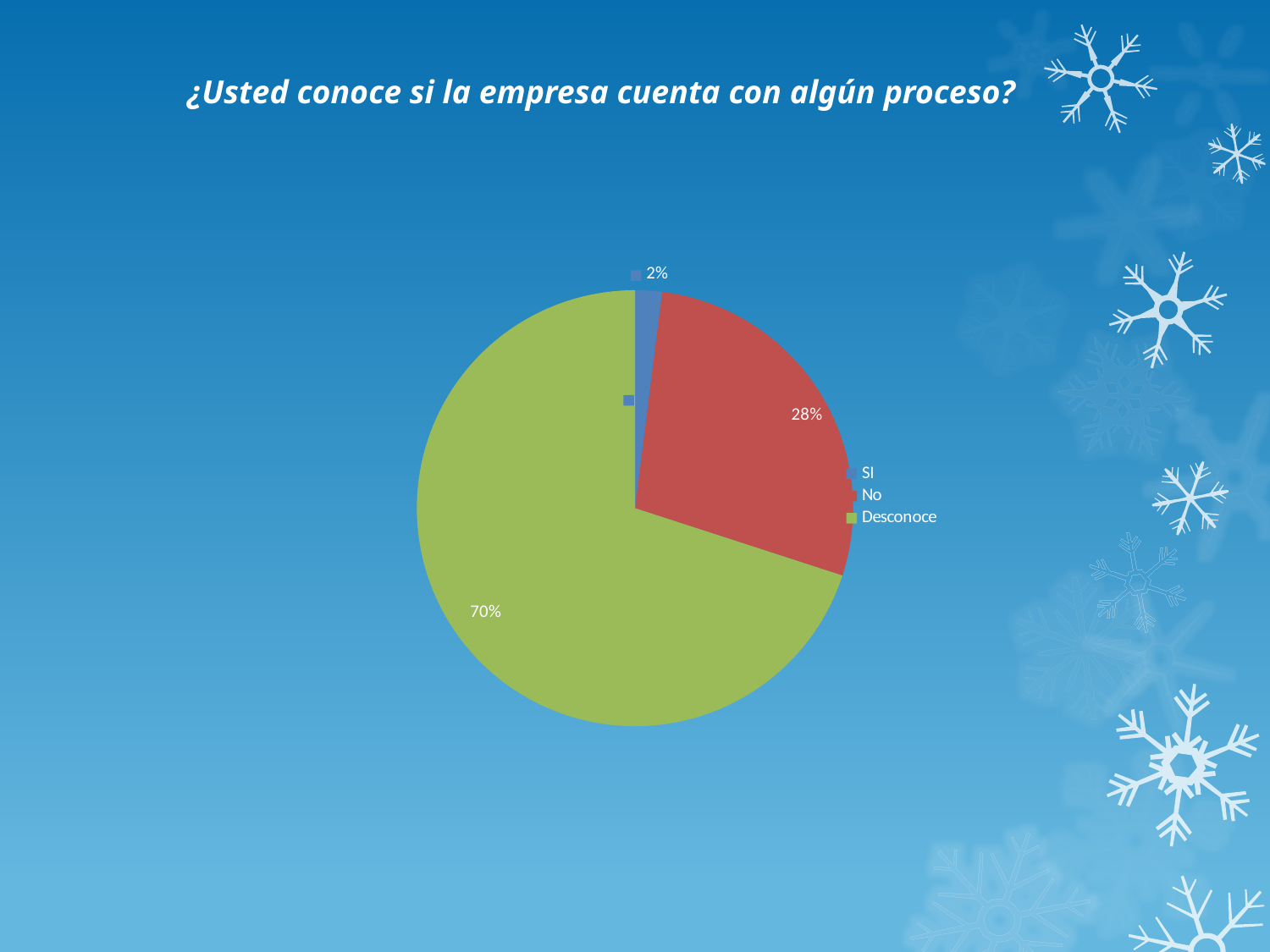
What is the difference in percentage points between the "Desconoce" slice and the "No" slice? 42 What is the combined percentage of the "SI" and "No" slices? 30% What colour is the "Desconoce" slice? green Which slice is larger, "No" or "SI"? No What percentage of the pie is labelled for "SI"? 2% How many categories does the legend list? 3 Which category has the largest slice of the pie? Desconoce What is the title of the chart? ¿Usted conoce si la empresa cuenta con algún proceso? What percentage of the pie is labelled for "No"? 28% What percentage of the pie is labelled for "Desconoce"? 70% Which category has the smallest slice of the pie? SI What kind of chart is shown on the slide? pie chart